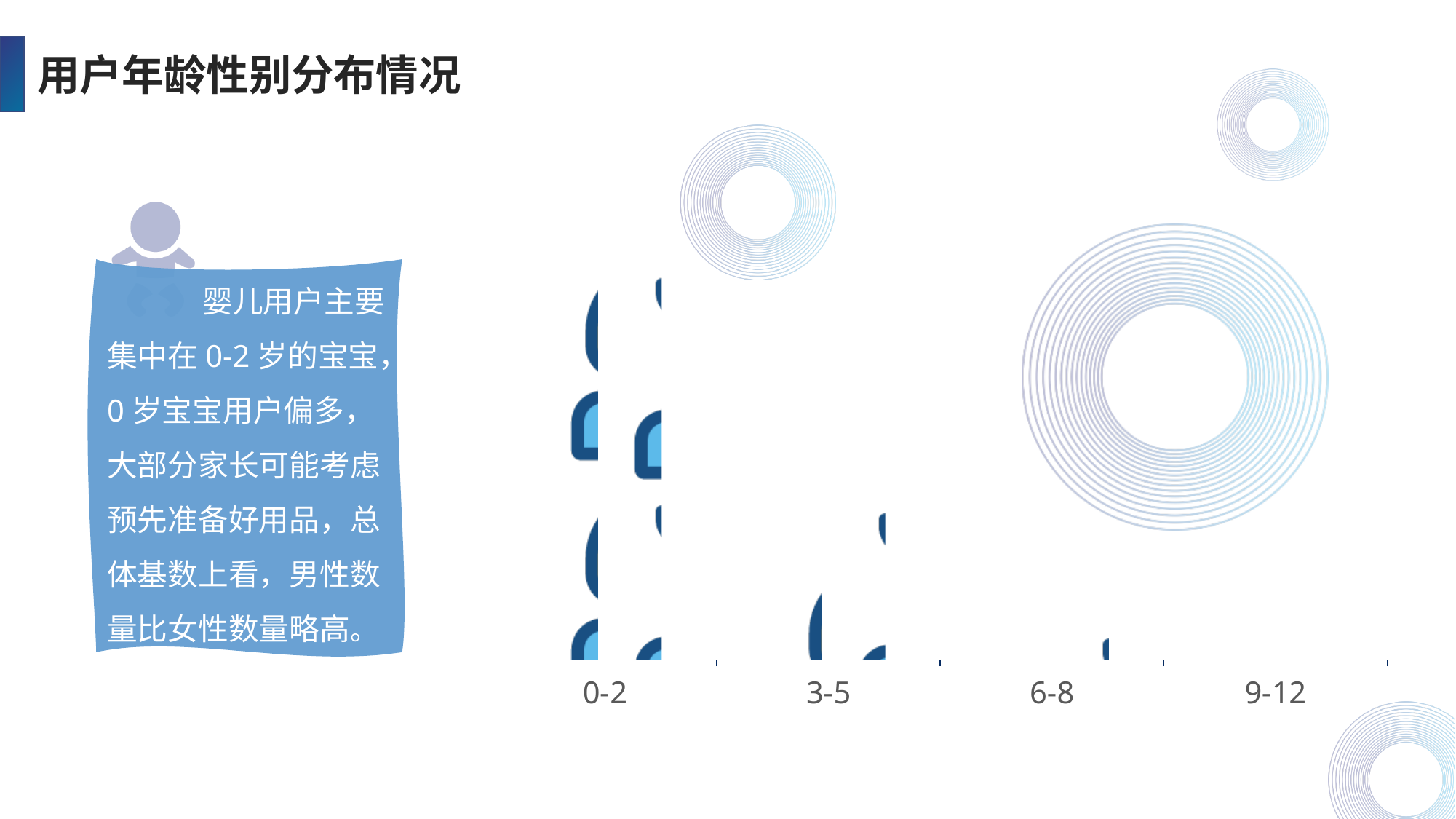
Which age category has the lowest value in the chart? 9-12 What is the label of the last category on the x axis? 9-12 What kind of chart is shown on the slide? bar chart Which is larger, the value for 3-5 or the value for 9-12? 3-5 Which is larger, the value for 0-2 or the value for 3-5? 0-2 How many age categories are shown on the x axis of the chart? 4 What is the label of the first category on the x axis? 0-2 Which is larger, the value for 0-2 or the value for 6-8? 0-2 Which age category has the highest value in the chart? 0-2 Do the values rise or fall along the x axis from 0-2 to 9-12? fall